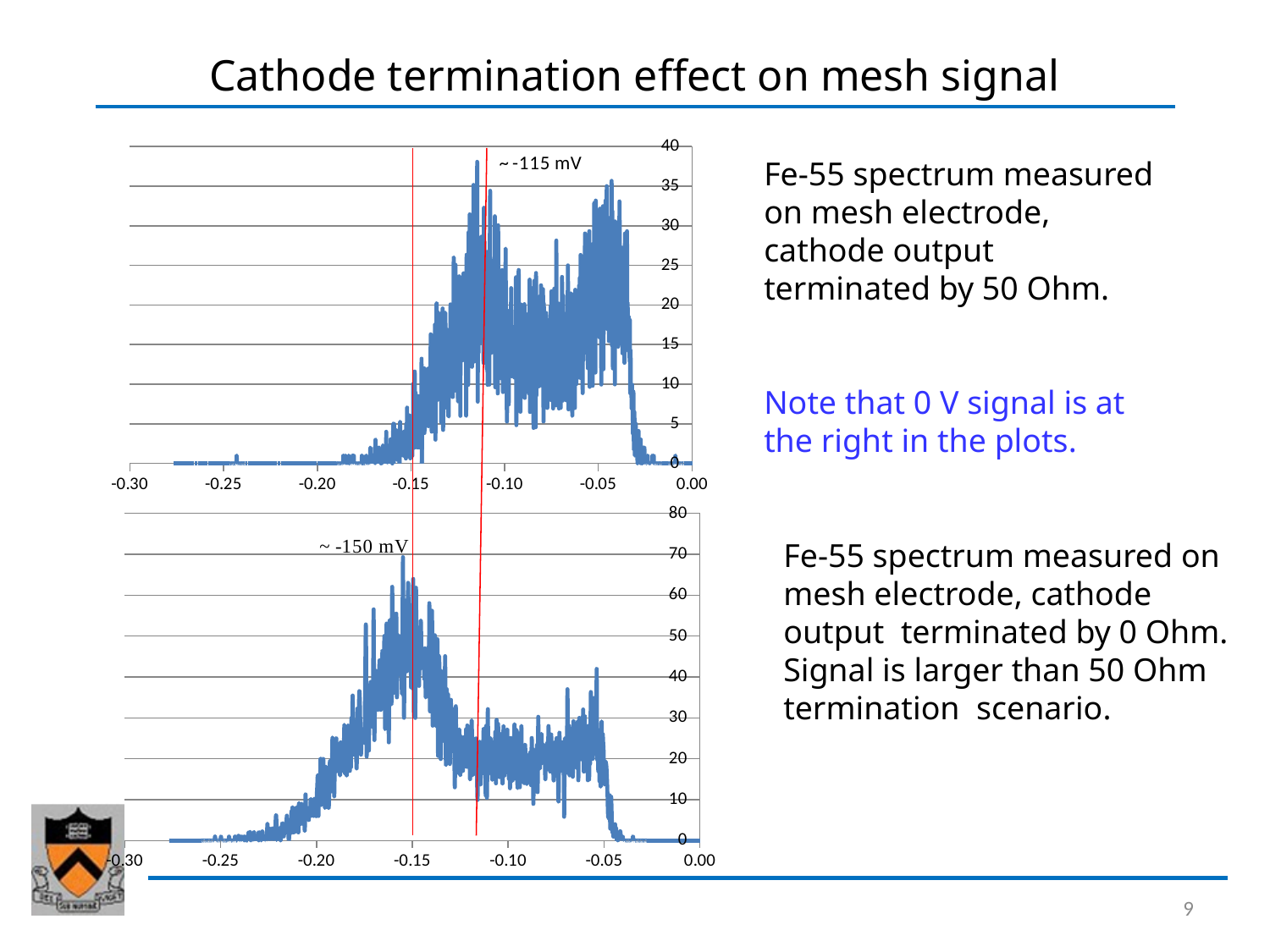
What voltage annotation is written next to the red line in the top chart? ~ -115 mV In the top chart, is the value at -0.25 on the horizontal axis greater or less than 5? less In the top chart, is the maximum peak height greater or less than 35? greater How many charts are shown on the slide? 2 In the bottom chart, what is the highest value shown on the vertical axis? 80 What kind of chart is the top chart on the slide? line chart In the bottom chart, is the maximum peak height greater or less than 60? greater In the top chart, what is the highest value shown on the vertical axis? 40 What voltage annotation is written near the main peak in the bottom chart? ~ -150 mV What is the leftmost value shown on the horizontal axis of the top chart? -0.30 Which chart reaches a higher peak count, the top chart or the bottom chart? the bottom chart